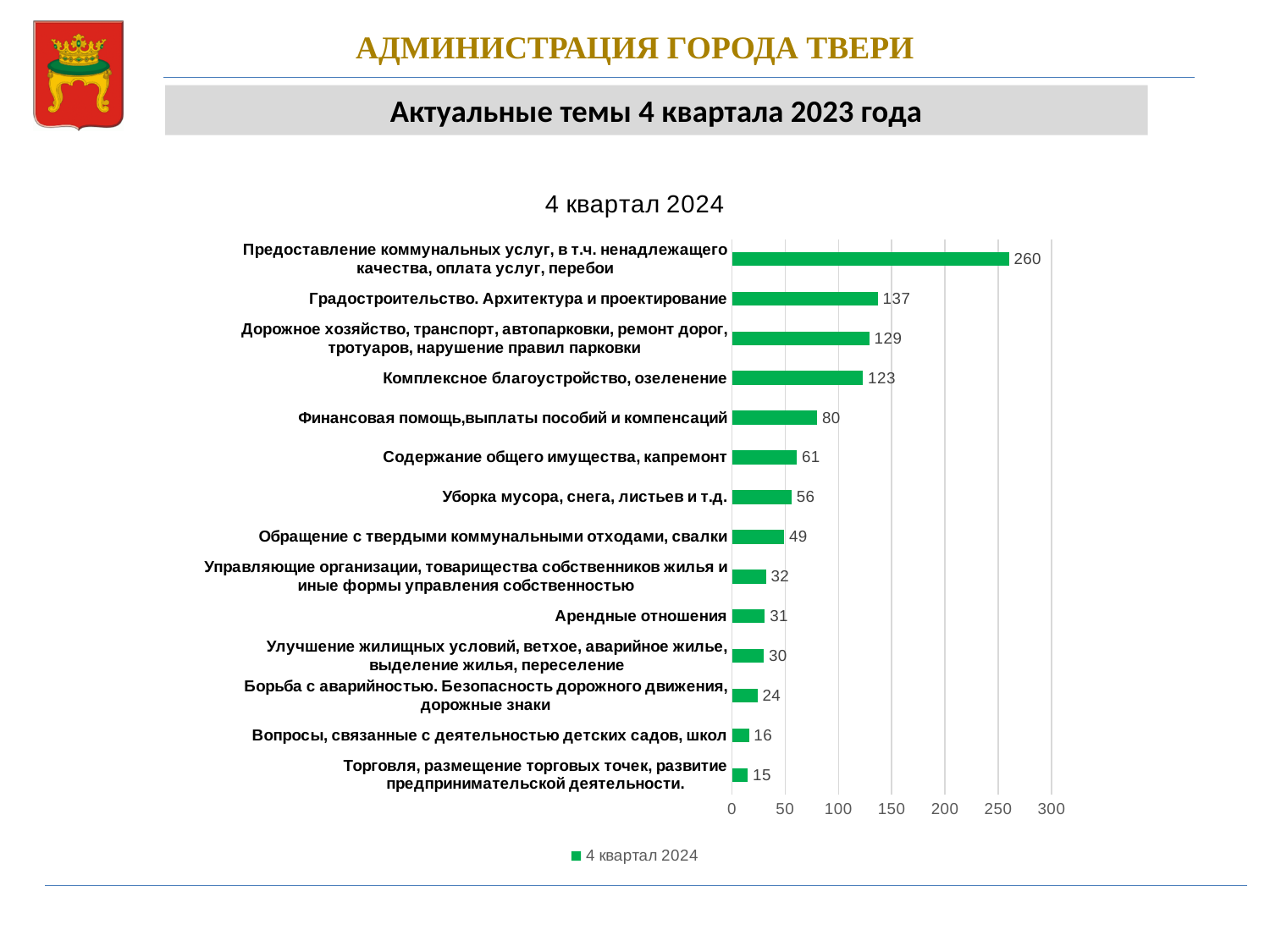
Which category has the lowest value? Торговля, размещение торговых точек, развитие предпринимательской деятельности. Which category has the highest value? Предоставление коммунальных услуг, в т.ч. ненадлежащего качества, оплата услуг, перебои What is the value for «Уборка мусора, снега, листьев и т.д.»? 56 What is the value for «Арендные отношения»? 31 What is the title of the chart? 4 квартал 2024 What is the difference between the values for «Предоставление коммунальных услуг...» (260) and «Градостроительство. Архитектура и проектирование» (137)? 123 Which is larger: the value for «Финансовая помощь, выплаты пособий и компенсаций» or for «Содержание общего имущества, капремонт»? Финансовая помощь, выплаты пособий и компенсаций What is the value for «Градостроительство. Архитектура и проектирование»? 137 Is the value for «Комплексное благоустройство, озеленение» greater or less than 100? greater What kind of chart is shown on the slide? Bar chart How many series does the legend list? 1 How many categories are shown in the chart? 14